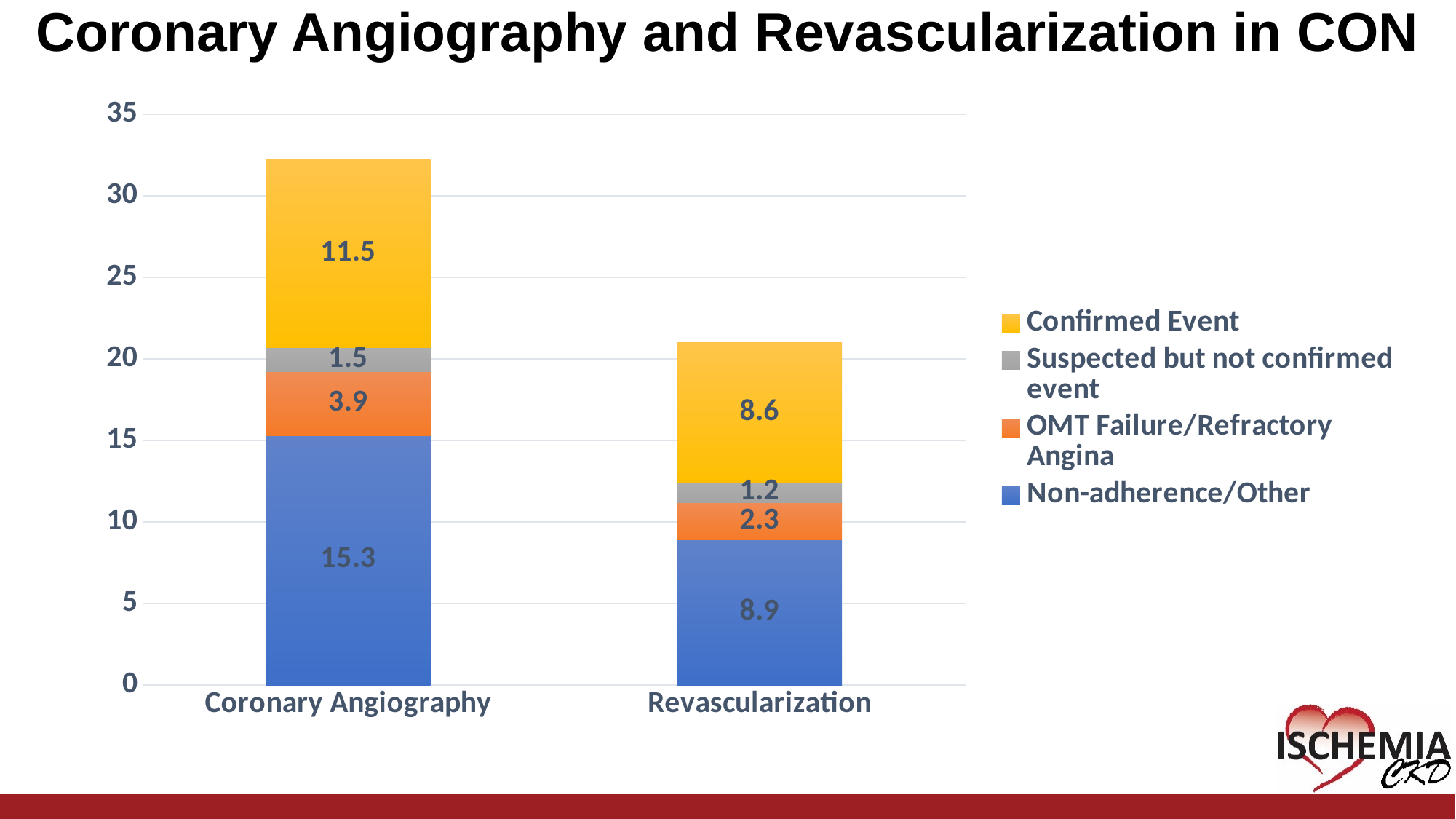
What is the Confirmed Event value for Revascularization? 8.6 How many categories are shown on the x axis? 2 What is the total of the stacked bar for Revascularization? 21.0 Which category has the larger Confirmed Event value, Coronary Angiography or Revascularization? Coronary Angiography Is the total for the Revascularization bar greater or less than 25? less What kind of chart is shown on the slide? Stacked bar chart What is the Non-adherence/Other value for Coronary Angiography? 15.3 What is the difference between the Non-adherence/Other values for Coronary Angiography and Revascularization? 6.4 How many series does the legend list? 4 What is the total of the stacked bar for Coronary Angiography? 32.2 What is the Suspected but not confirmed event value for Revascularization? 1.2 What is the OMT Failure/Refractory Angina value for Coronary Angiography? 3.9